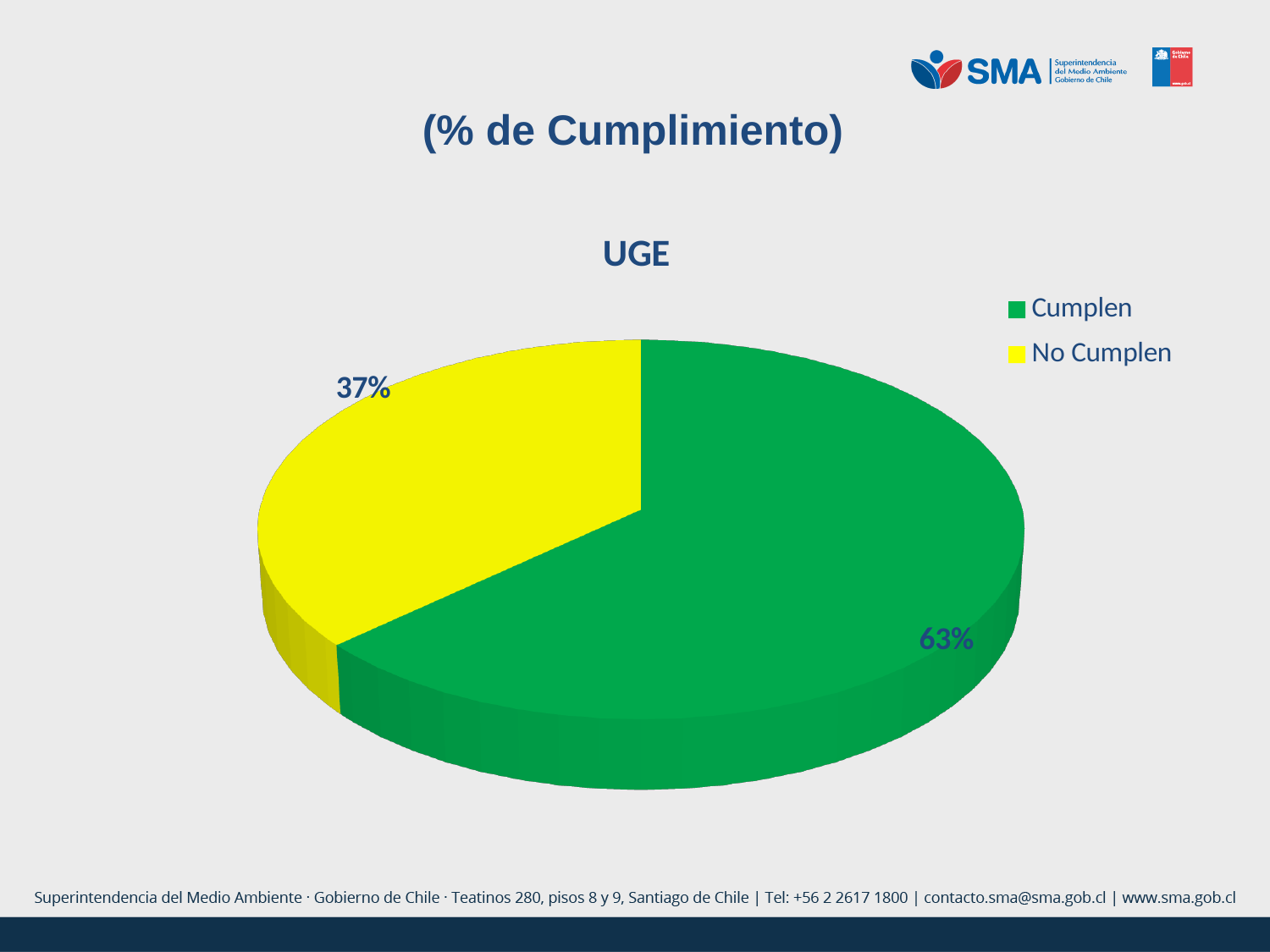
How many entries does the legend list? 2 What kind of chart is shown on the slide? Pie chart What colour is the Cumplen slice? Green What is the title of the chart? UGE Which slice is the smallest in the pie chart? No Cumplen What share of the pie does No Cumplen represent? 37% Which is larger, Cumplen or No Cumplen? Cumplen How many slices does the pie chart have? 2 What percentage of the pie is labelled No Cumplen? 37% Which slice is the largest in the pie chart? Cumplen What is the difference in percentage points between Cumplen and No Cumplen? 26 What percentage of the pie is labelled Cumplen? 63%